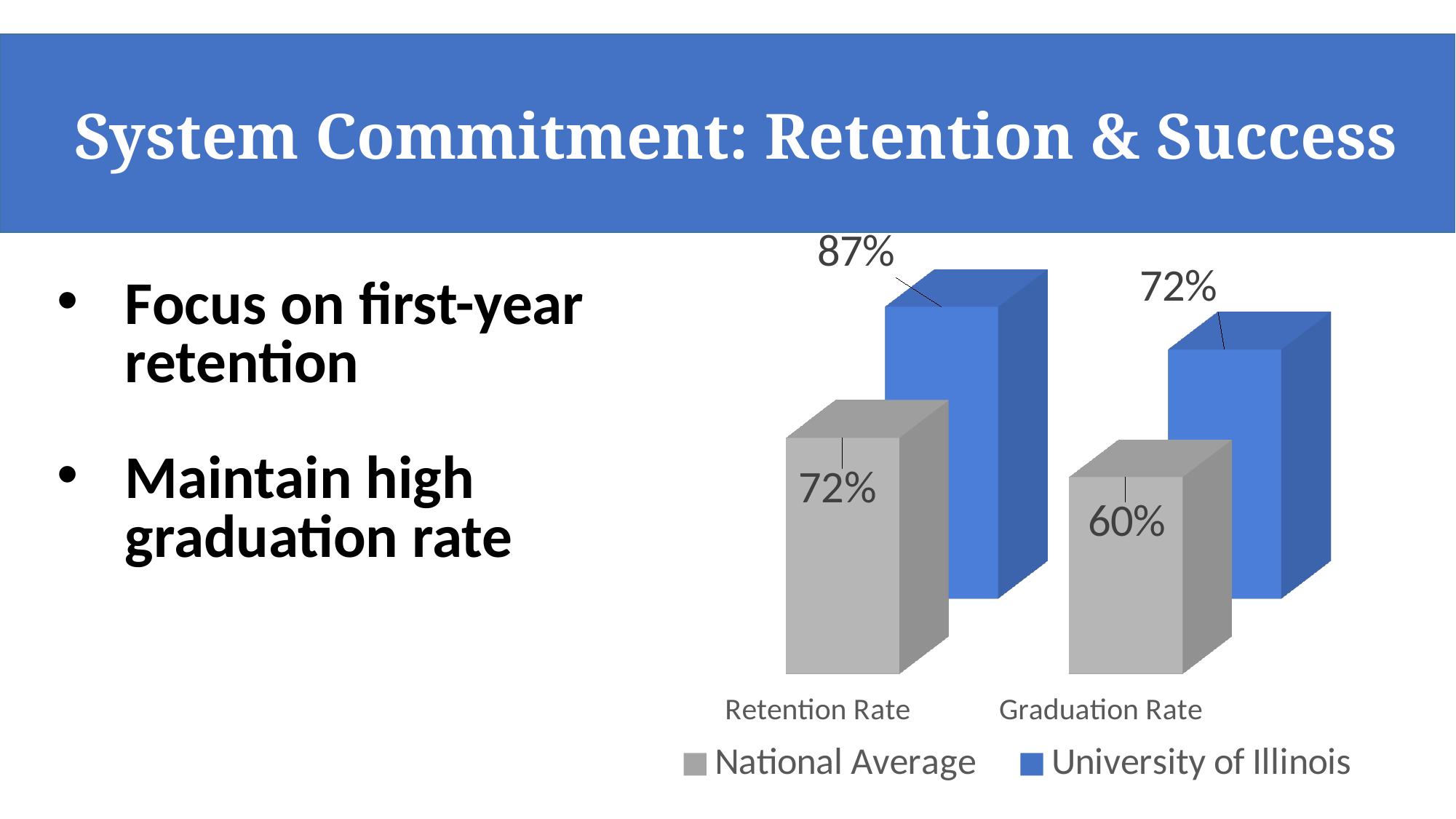
What is the National Average graduation rate shown on the chart? 60% Which series has the higher retention rate, National Average or University of Illinois? University of Illinois What kind of chart is shown on the slide? Bar chart How many series does the chart legend list? 2 What is the National Average retention rate shown on the chart? 72% What is the difference between the University of Illinois graduation rate and the National Average graduation rate? 12% Which bar on the chart has the highest value? University of Illinois Retention Rate Which series has the lower graduation rate, National Average or University of Illinois? National Average What is the difference between the University of Illinois retention rate and the National Average retention rate? 15% What is the University of Illinois retention rate shown on the chart? 87% Which bar on the chart has the lowest value? National Average Graduation Rate What is the University of Illinois graduation rate shown on the chart? 72%